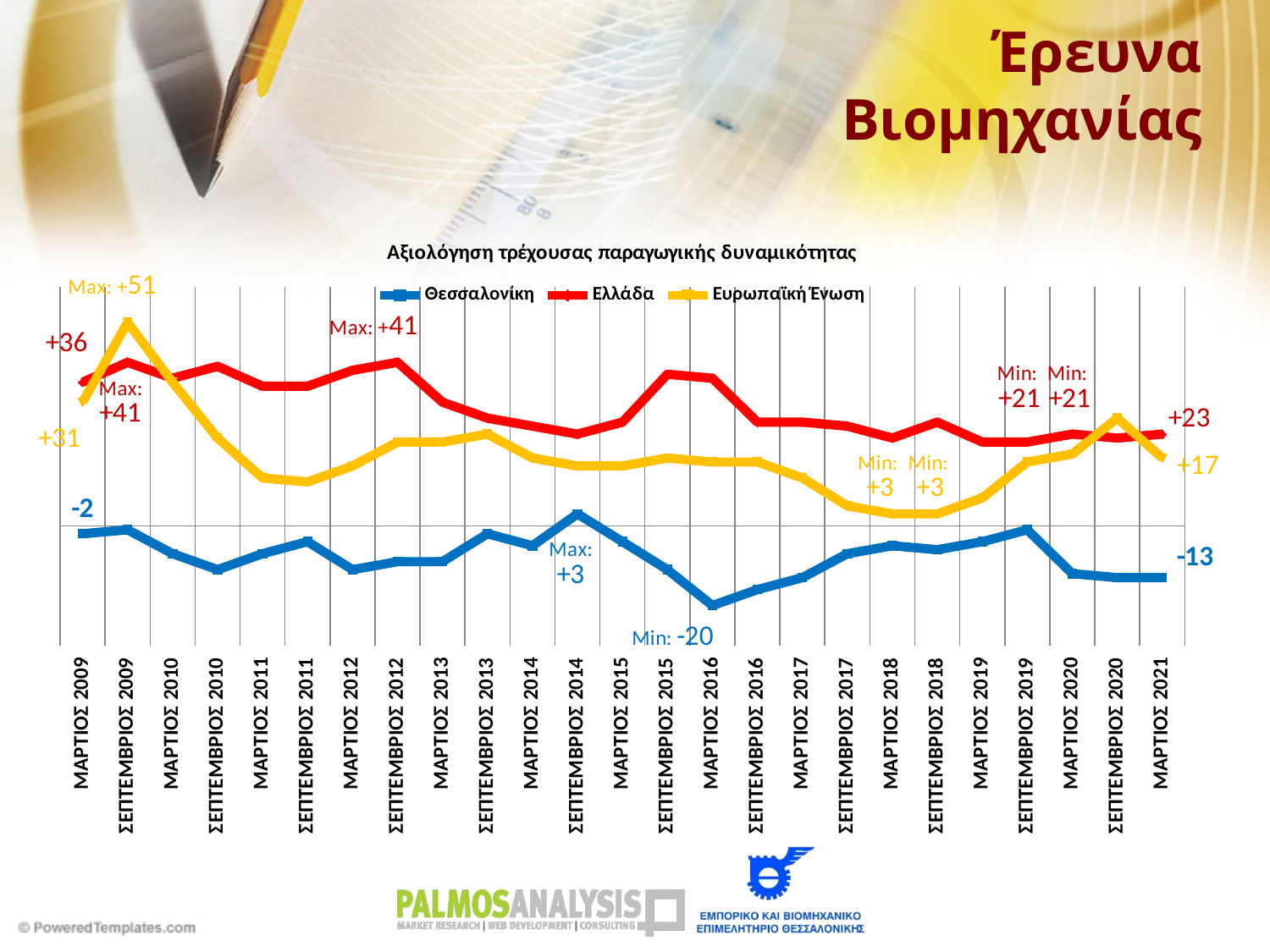
What is the value for Θεσσαλονίκη in ΜΑΡΤΙΟΣ 2009? -2 What is the maximum value reached by the Ευρωπαϊκή Ένωση series? +51 How many time points are shown on the x axis? 25 What is the value for Θεσσαλονίκη in ΜΑΡΤΙΟΣ 2021? -13 What kind of chart is shown on the slide? line chart What is the minimum value reached by the Θεσσαλονίκη series? -20 What is the value for Ελλάδα in ΜΑΡΤΙΟΣ 2021? +23 What is the value for Ευρωπαϊκή Ένωση in ΜΑΡΤΙΟΣ 2021? +17 What is the minimum value reached by the Ελλάδα series? +21 What is the title of the chart? Αξιολόγηση τρέχουσας παραγωγικής δυναμικότητας In ΜΑΡΤΙΟΣ 2021, which is larger: the value for Ελλάδα or for Ευρωπαϊκή Ένωση? Ελλάδα How many series does the legend list? 3